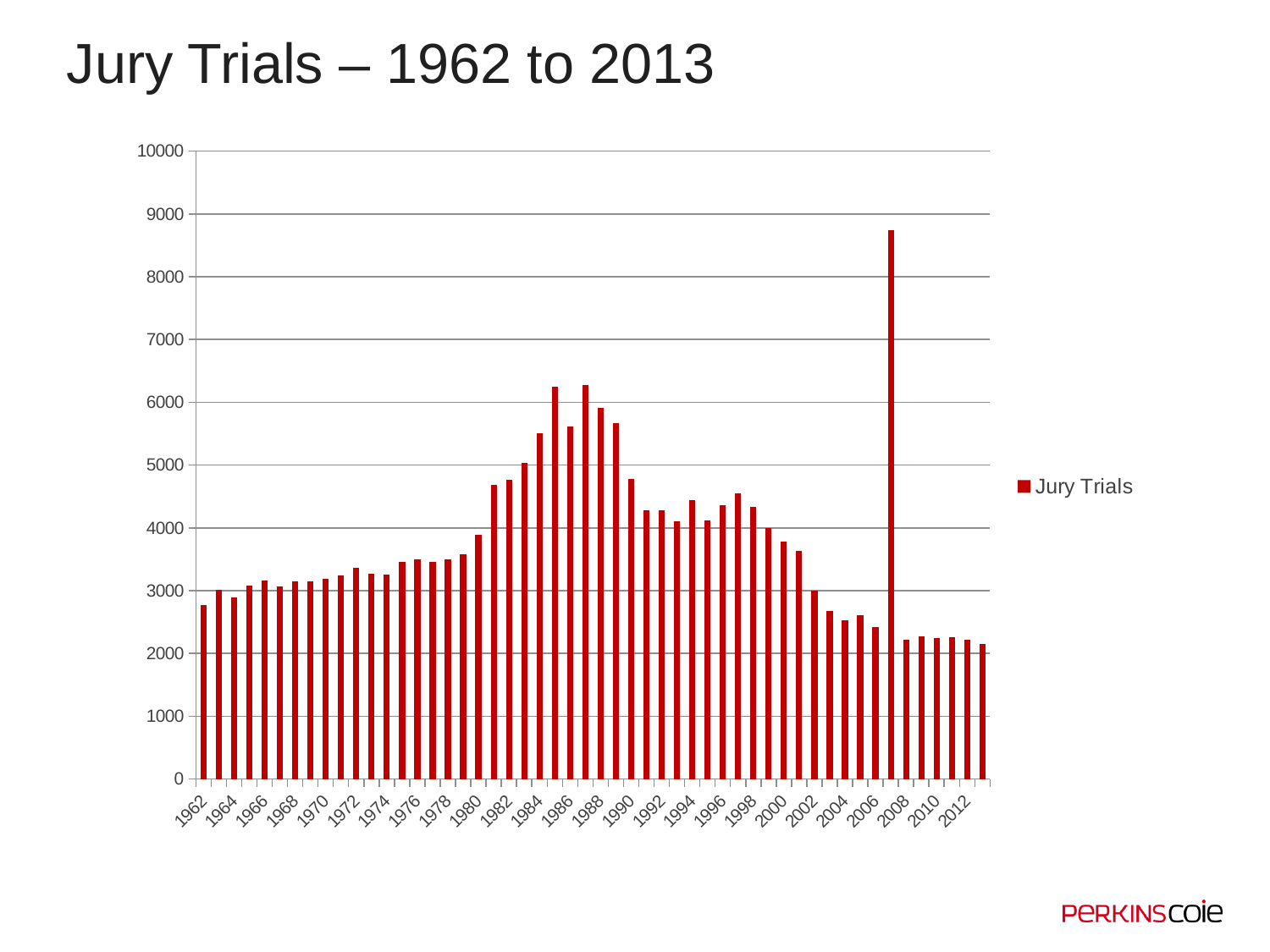
Is the value for 2007 greater or less than 8000? greater Is the value for 1987 greater or less than 6000? greater What kind of chart is shown on the slide? Bar chart Do the values generally rise or fall from 1988 to 2006? Fall Is the value for 1962 greater or less than 3000? less Which year has the highest bar in the chart? 2007 Do the values generally rise or fall from 1962 to 1987? Rise What is the name of the series shown in the legend? Jury Trials How many series does the legend list? 1 Which year has the larger value, 1987 or 1962? 1987